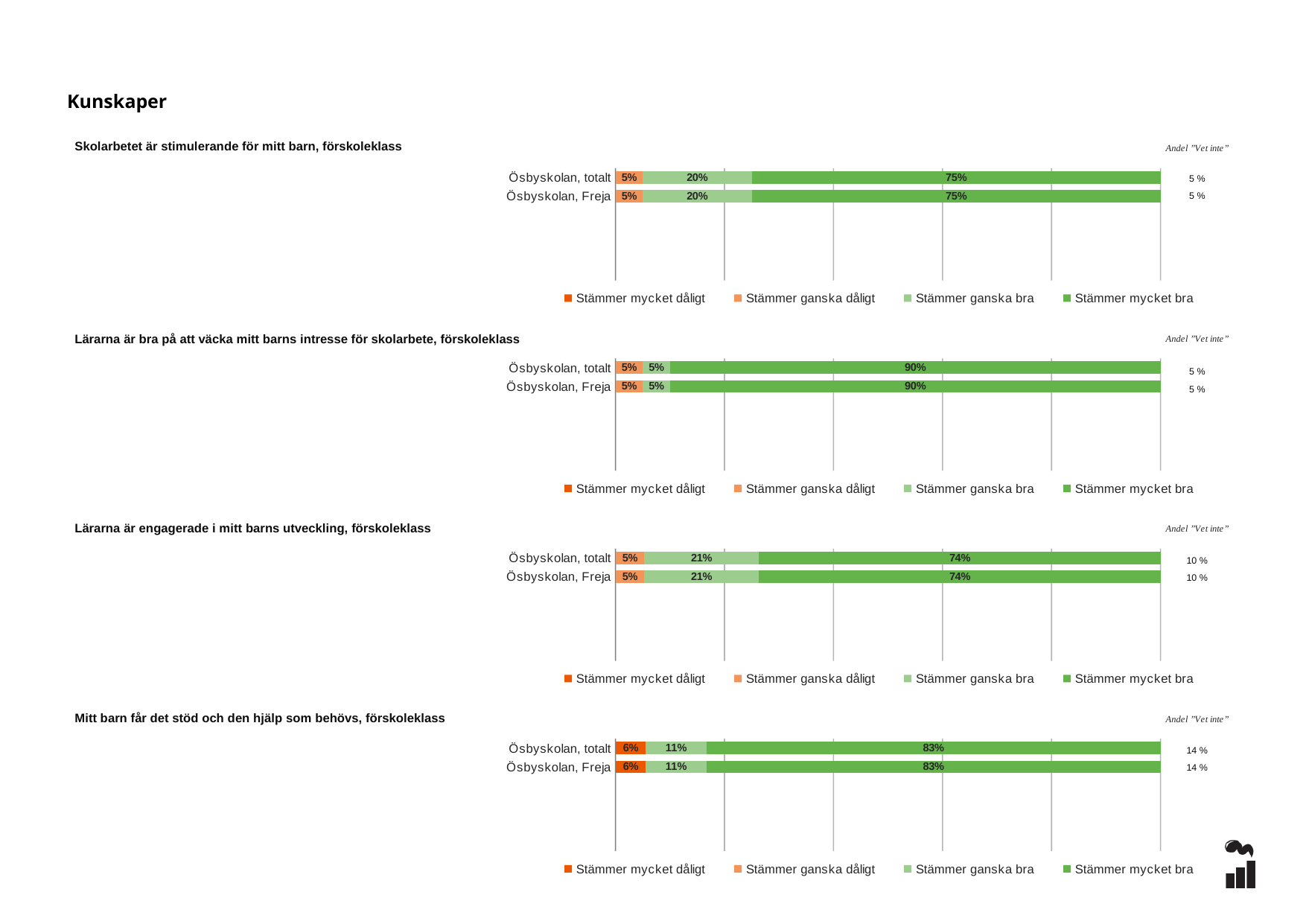
In the chart titled "Skolarbetet är stimulerande för mitt barn, förskoleklass", what is the value of the "Stämmer ganska bra" segment for Ösbyskolan, Freja? 20% How many categories (bars) are shown in the chart titled "Mitt barn får det stöd och den hjälp som behövs, förskoleklass"? 2 In the chart titled "Lärarna är engagerade i mitt barns utveckling, förskoleklass", what is the value of the "Stämmer ganska bra" segment for Ösbyskolan, totalt? 21% In the chart titled "Lärarna är bra på att väcka mitt barns intresse för skolarbete, förskoleklass", what is the value of the "Stämmer mycket bra" segment for Ösbyskolan, totalt? 90% What kind of chart is used for "Lärarna är engagerade i mitt barns utveckling, förskoleklass"? Stacked bar chart How many series does the legend list in the chart titled "Skolarbetet är stimulerande för mitt barn, förskoleklass"? 4 In the chart titled "Lärarna är bra på att väcka mitt barns intresse för skolarbete, förskoleklass", which segment is larger for Ösbyskolan, Freja: "Stämmer ganska bra" or "Stämmer mycket bra"? Stämmer mycket bra In the chart titled "Mitt barn får det stöd och den hjälp som behövs, förskoleklass", what is the Andel "Vet inte" value shown for Ösbyskolan, totalt? 14 % What is the title of the bottom chart on the slide? Mitt barn får det stöd och den hjälp som behövs, förskoleklass In the chart titled "Lärarna är engagerade i mitt barns utveckling, förskoleklass", what is the difference between the "Stämmer mycket bra" and "Stämmer ganska bra" segments for Ösbyskolan, totalt? 53% In the chart titled "Skolarbetet är stimulerande för mitt barn, förskoleklass", what is the value of the "Stämmer mycket bra" segment for Ösbyskolan, totalt? 75% In the chart titled "Mitt barn får det stöd och den hjälp som behövs, förskoleklass", what is the value of the "Stämmer mycket bra" segment for Ösbyskolan, Freja? 83%